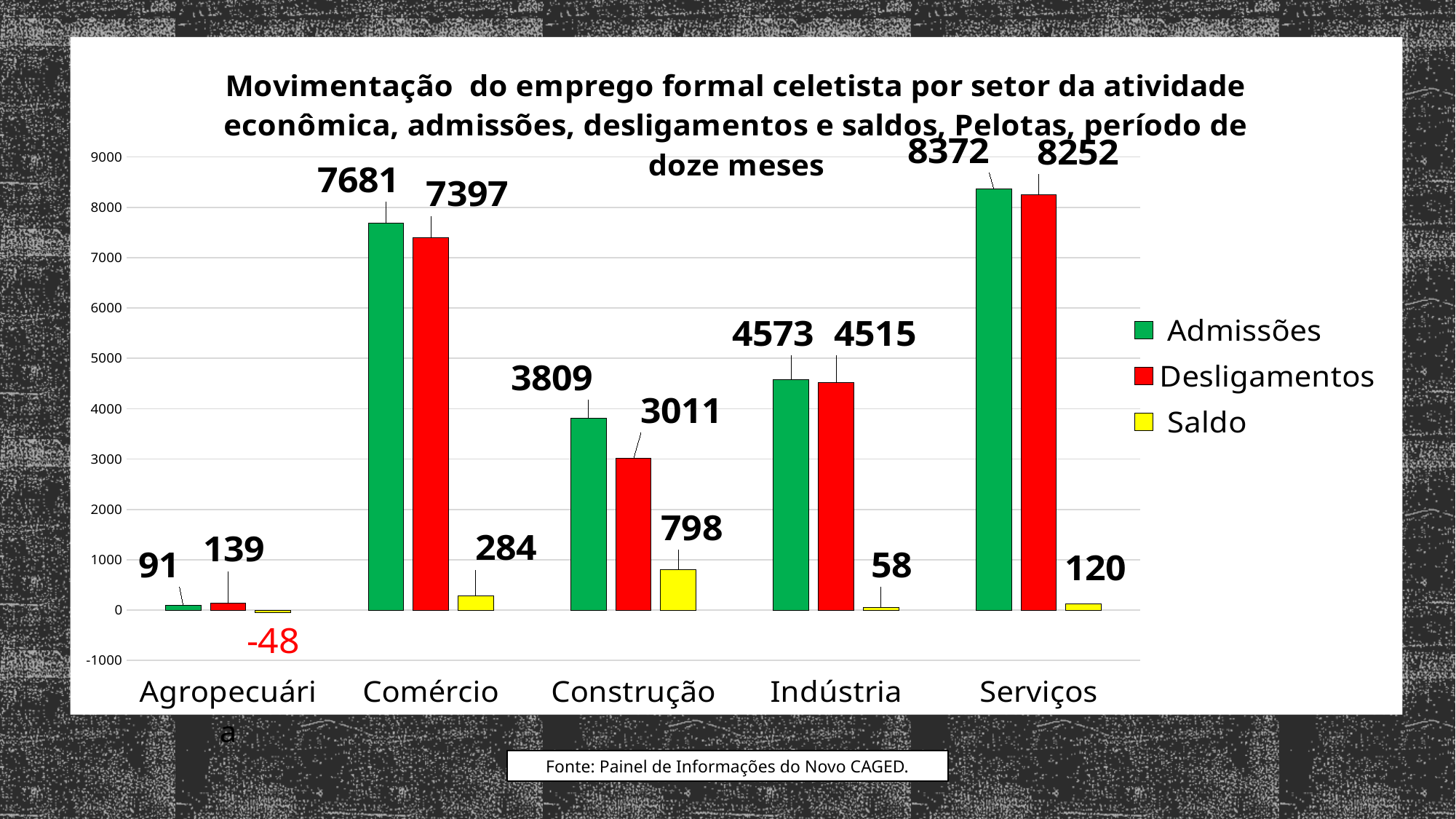
What is the Admissões value for Comércio? 7681 Which sector has the lowest Desligamentos value? Agropecuária How many sectors are shown on the x axis? 5 Which sector has the highest Admissões value? Serviços What is the Desligamentos value for Construção? 3011 What is the difference between Admissões and Desligamentos for Serviços? 120 How many series does the legend list? 3 Which is larger for Construção, Admissões or Desligamentos? Admissões Which colour represents the Saldo series in the legend? Yellow What kind of chart is shown on the slide? Bar chart What is the Saldo value for Agropecuária? -48 What is the Saldo value for Indústria? 58